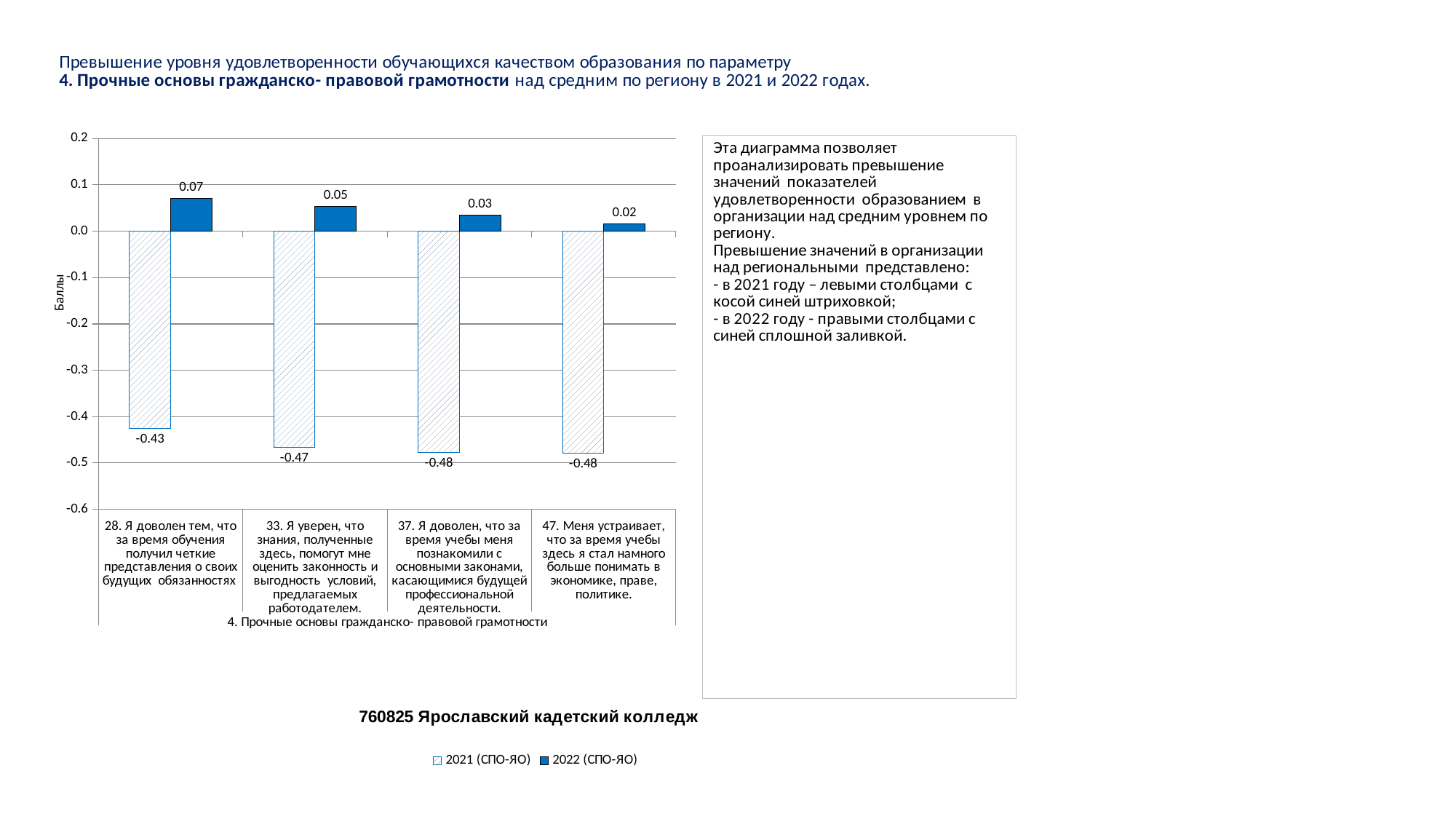
What is the value for 2021 (СПО-ЯО) for category 37 (Я доволен, что за время учебы меня познакомили с основными законами, касающимися будущей профессиональной деятельности)? -0.48 Which category has the highest value for the 2022 (СПО-ЯО) series? 28. Я доволен тем, что за время обучения получил четкие представления о своих будущих обязанностях Which is larger: the 2022 (СПО-ЯО) value for category 33 or for category 37? Category 33 (0.05) What is the value for 2022 (СПО-ЯО) for category 47 (Меня устраивает, что за время учебы здесь я стал намного больше понимать в экономике, праве, политике)? 0.02 What is the value for 2021 (СПО-ЯО) for category 33 (Я уверен, что знания, полученные здесь, помогут мне оценить законность и выгодность условий, предлагаемых работодателем)? -0.47 Do the 2022 (СПО-ЯО) values rise or fall from left to right along the x axis? Fall What kind of chart is shown on the slide? Bar chart Which category has the highest (least negative) value for the 2021 (СПО-ЯО) series? 28. Я доволен тем, что за время обучения получил четкие представления о своих будущих обязанностях How many series does the legend list? 2 How many categories are shown on the x axis of the chart? 4 What is the value for 2022 (СПО-ЯО) for category 28 (Я доволен тем, что за время обучения получил четкие представления о своих будущих обязанностях)? 0.07 What is the difference between the 2022 (СПО-ЯО) values for category 28 and category 47? 0.05